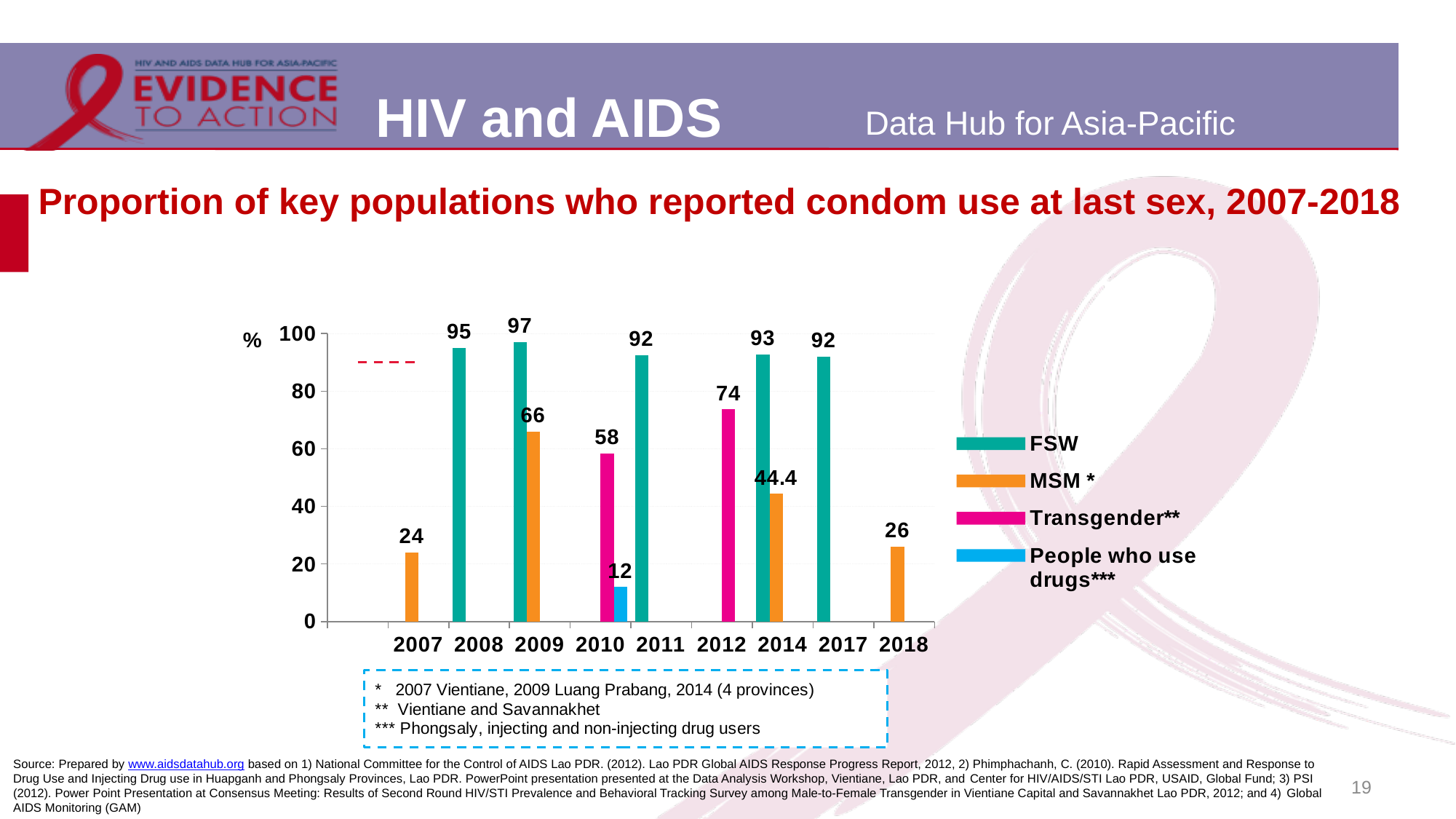
What is the difference between the FSW and MSM * values in 2009? 31 In which year is the MSM * value lowest? 2007 In which year is the FSW value highest? 2009 What kind of chart is shown on the slide? bar chart How many series does the legend list? 4 What is the value for FSW in 2009? 97 Which is larger, the Transgender** value in 2010 or in 2012? 2012 What is the value for People who use drugs*** in 2010? 12 Which series is shown in orange in the legend? MSM * How many years are shown on the x axis? 9 What is the value for Transgender** in 2012? 74 What is the value for MSM * in 2014? 44.4